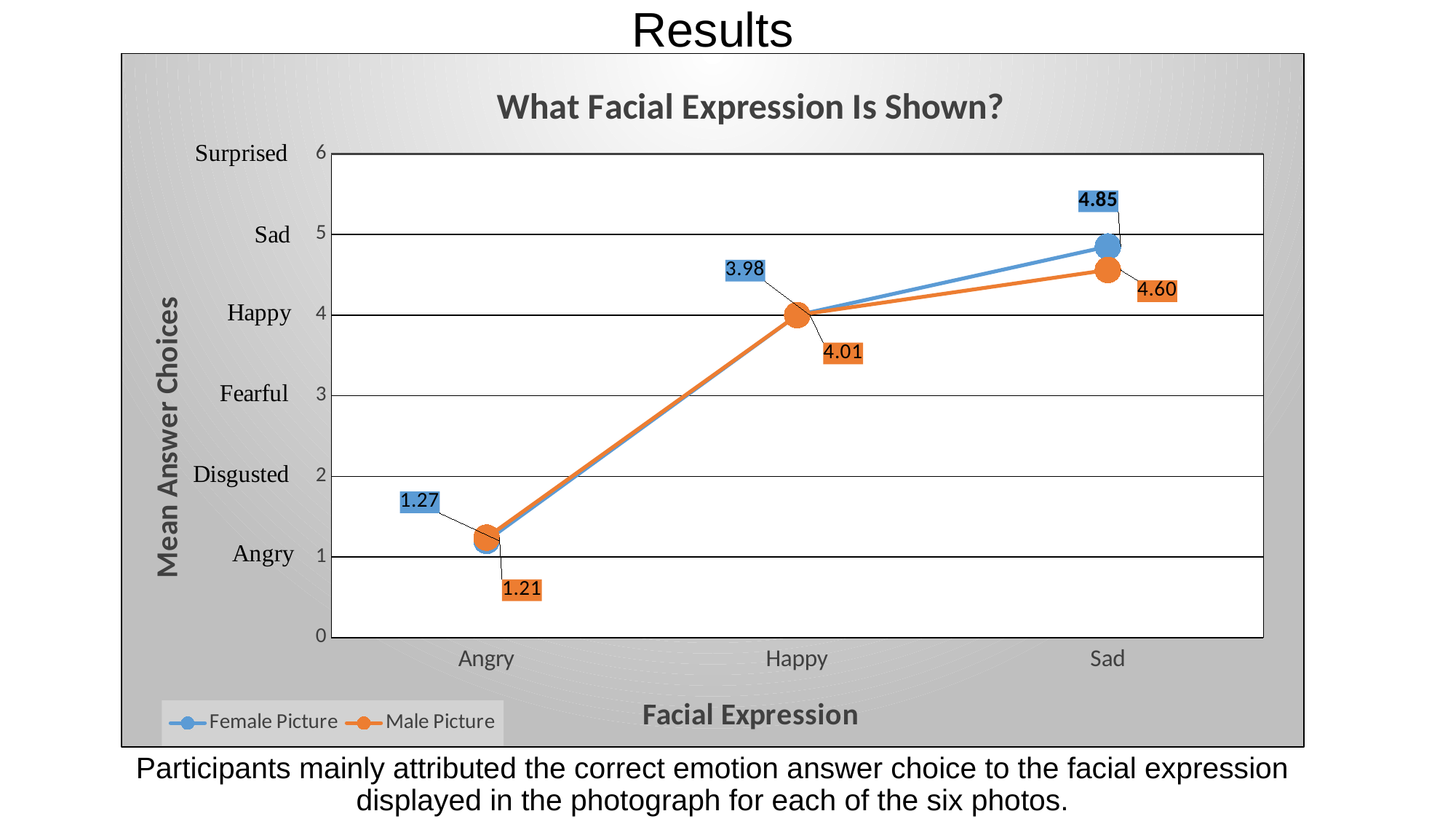
What is the Male Picture value for Angry? 1.21 What is the difference between the Female Picture and Male Picture values for Sad? 0.25 What kind of chart is this? Line chart How many series does the legend list? 2 Which facial expression has the highest Female Picture value? Sad Which facial expression has the lowest Male Picture value? Angry What is the Male Picture value for Happy? 4.01 What is the Female Picture value for Angry? 1.27 For Sad, which is larger: the Female Picture value or the Male Picture value? Female Picture How many facial expression categories are shown on the x axis? 3 What is the Female Picture value for Sad? 4.85 Is the Male Picture value for Sad greater or less than 4? greater